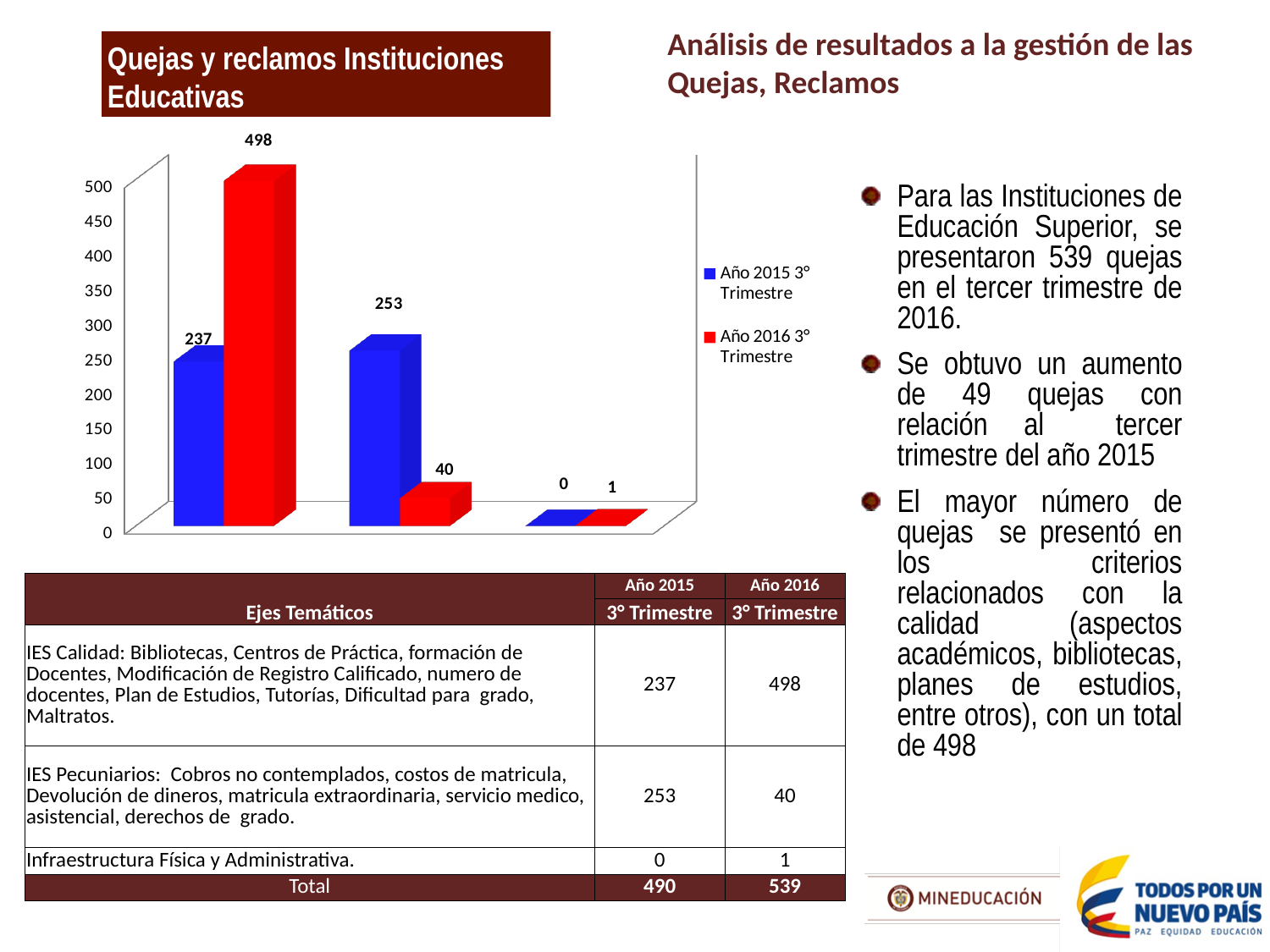
In the first (leftmost) group of bars, what is the difference between the Año 2016 3° Trimestre value and the Año 2015 3° Trimestre value? 261 In the chart, what is the value of the Año 2016 3° Trimestre bar in the first (leftmost) group of bars? 498 What colour represents the Año 2016 3° Trimestre series in the chart? Red In the chart, what is the value of the Año 2016 3° Trimestre bar in the second (middle) group of bars? 40 What kind of chart is shown on the slide? Bar chart In the first (leftmost) group of bars, which series has the larger value? Año 2016 3° Trimestre In the chart, what is the value of the Año 2015 3° Trimestre bar in the second (middle) group of bars? 253 In the second (middle) group of bars, what is the difference between the Año 2015 3° Trimestre value and the Año 2016 3° Trimestre value? 213 What is the highest value shown by any bar in the chart? 498 In the chart, what is the value of the Año 2015 3° Trimestre bar in the first (leftmost) group of bars? 237 What is the lowest value shown by any bar in the chart? 0 How many series does the chart legend list? 2